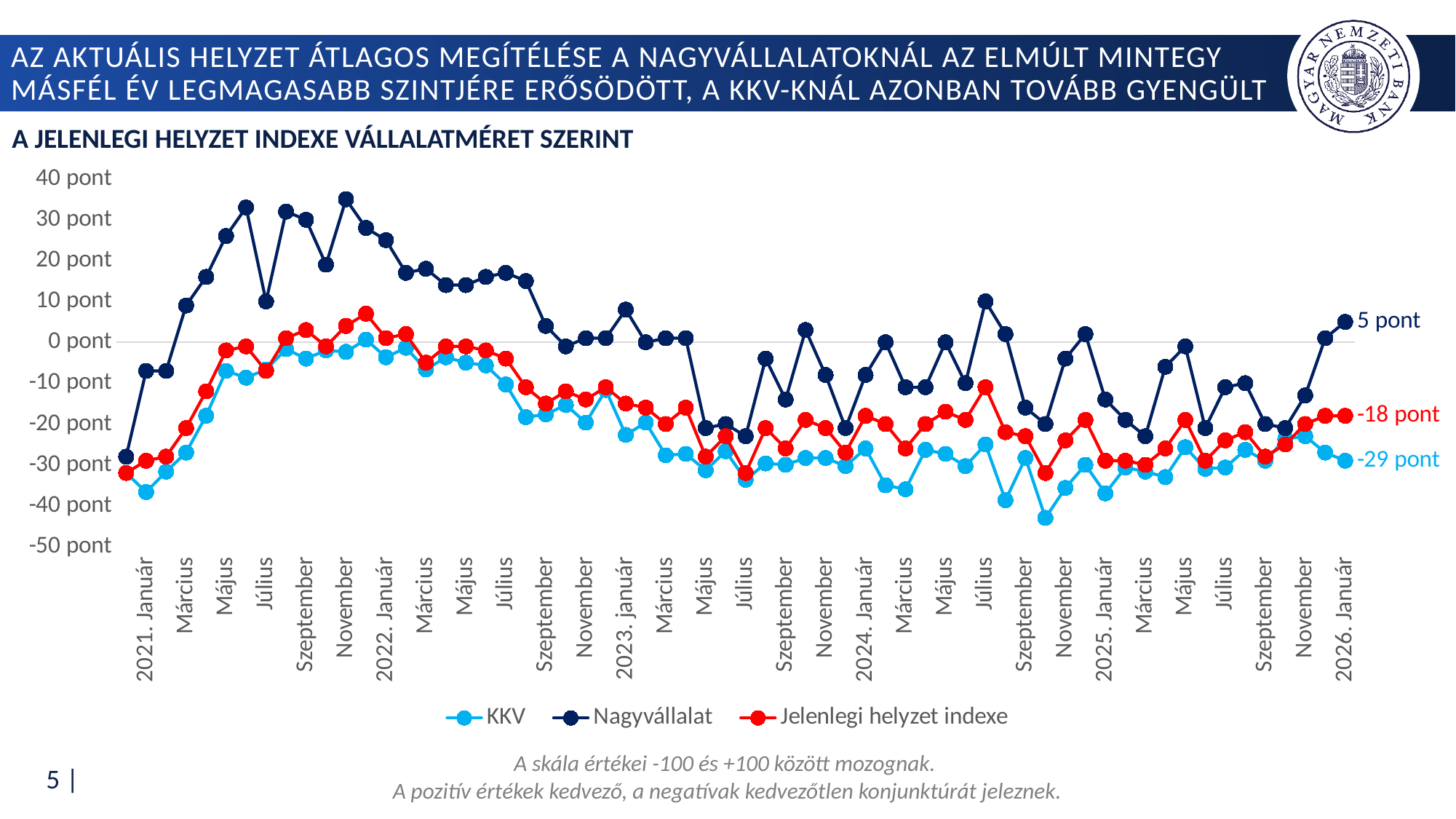
Is the Nagyvállalat value in November 2021 greater or less than 30 pont? greater What is the value of the Jelenlegi helyzet indexe series at 2026. Január? -18 pont What is the difference between the Nagyvállalat and KKV values at 2026. Január? 34 pont What kind of chart is shown on the slide? Line chart What is the difference between the Jelenlegi helyzet indexe and KKV values at 2026. Január? 11 pont What is the value of the KKV series at 2026. Január? -29 pont Which series has the highest value at 2026. Január? Nagyvállalat At 2026. Január, which is larger: the KKV value or the Nagyvállalat value? Nagyvállalat What is the title of the chart? A JELENLEGI HELYZET INDEXE VÁLLALATMÉRET SZERINT What is the value of the Nagyvállalat series at 2026. Január? 5 pont How many series does the legend list? 3 Is the Nagyvállalat value in Július 2023 greater or less than -10 pont? less